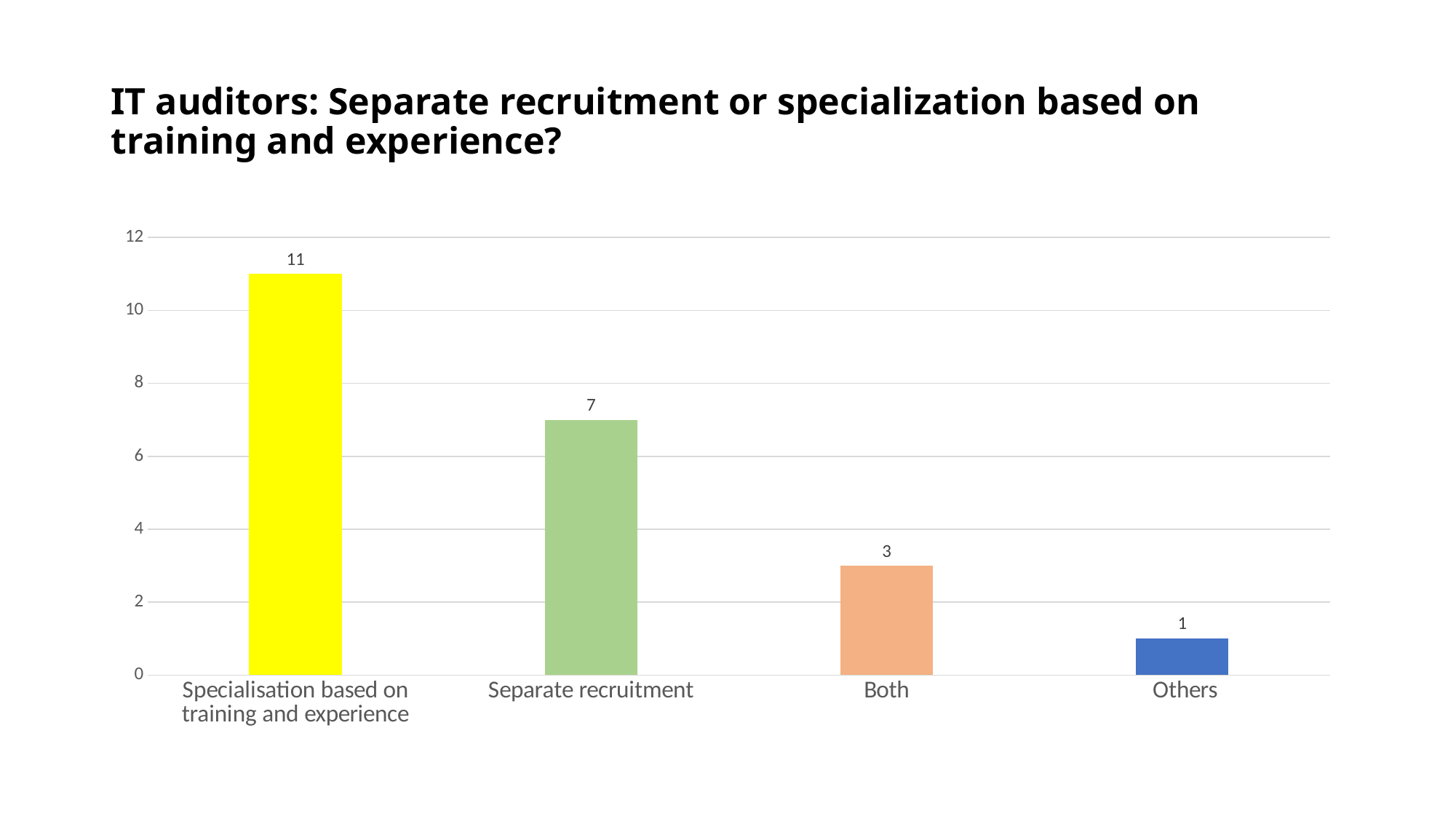
What is the value for Specialisation based on training and experience? 11 Which category has the lowest value? Others What is the value for Others? 1 Which is larger, the value for Separate recruitment or the value for Both? Separate recruitment Is the value for Separate recruitment greater or less than 8? less Which category has the highest value? Specialisation based on training and experience What is the difference between the values for Specialisation based on training and experience and Separate recruitment? 4 How many categories are shown on the x axis? 4 What kind of chart is shown on the slide? bar chart What is the value for Both? 3 What is the value for Separate recruitment? 7 Do the values rise or fall from left to right along the x axis? fall